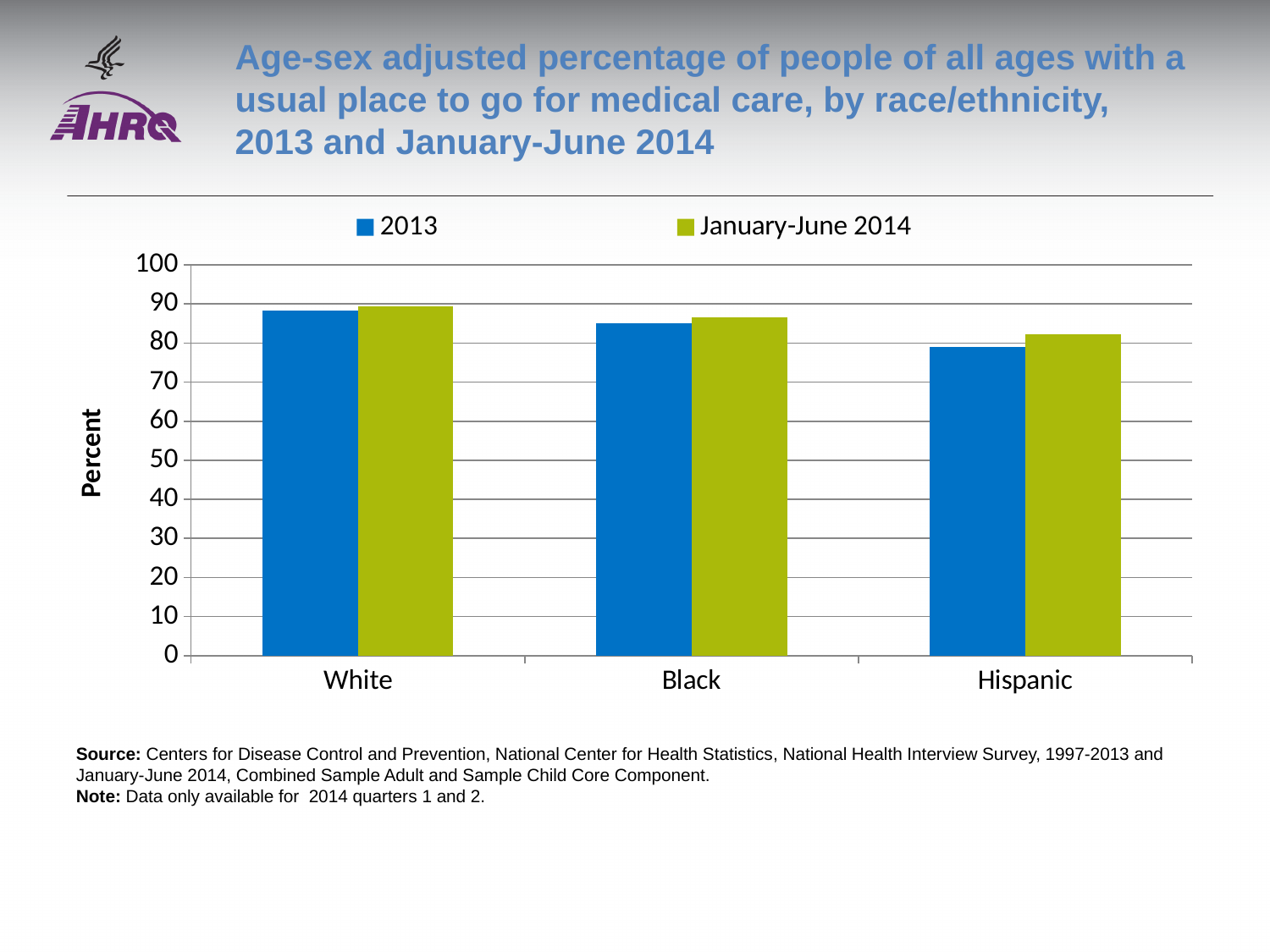
How many race/ethnicity categories are shown on the x axis? 3 Which race/ethnicity has the lowest value for 2013? Hispanic What are the two series named in the legend? 2013 and January-June 2014 What kind of chart is shown on the slide? bar chart For 2013, which is larger: the value for White or the value for Hispanic? White What is the label on the vertical axis? Percent Which race/ethnicity has the lowest value for January-June 2014? Hispanic Is the 2013 value for Hispanic greater or less than 70? greater Is the 2013 value for White greater or less than 80? greater Is the January-June 2014 value for Black greater or less than 90? less Which race/ethnicity has the highest value for January-June 2014? White How many series does the legend list? 2